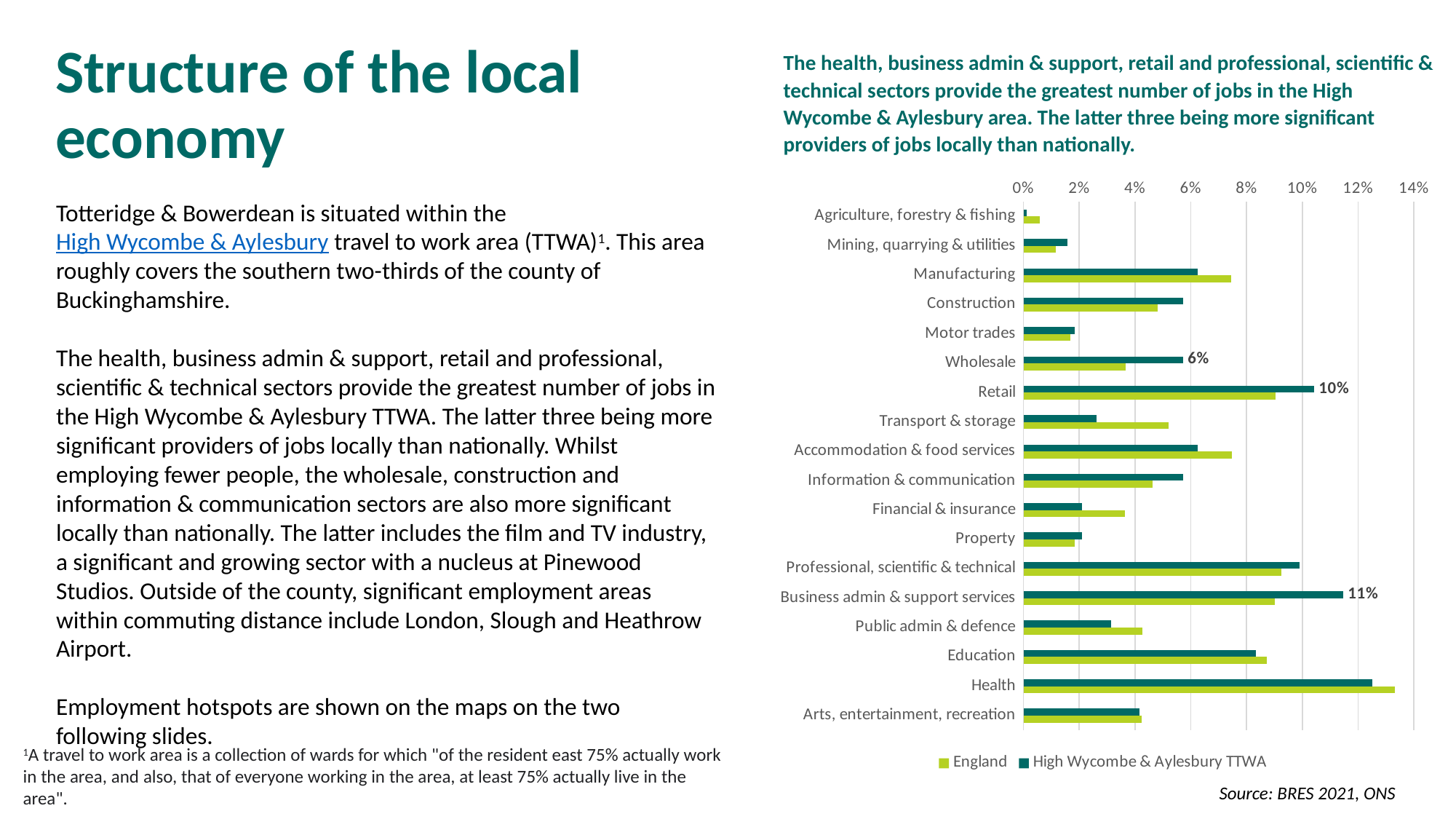
How many sector categories are plotted on the chart? 18 Which colour represents England in the chart legend? light green What kind of chart is shown on the slide? bar chart For Manufacturing, which series has the larger value, England or High Wycombe & Aylesbury TTWA? England What is the difference between the High Wycombe & Aylesbury TTWA values for Business admin & support services and Wholesale? 5 percentage points How many series does the chart legend list? 2 What is the High Wycombe & Aylesbury TTWA value for Retail? 10% Which sector has the lowest High Wycombe & Aylesbury TTWA value? Agriculture, forestry & fishing What is the High Wycombe & Aylesbury TTWA value for Wholesale? 6% Is the England value for Health greater or less than 12%? greater What is the High Wycombe & Aylesbury TTWA value for Business admin & support services? 11% Which sector has the highest England value? Health